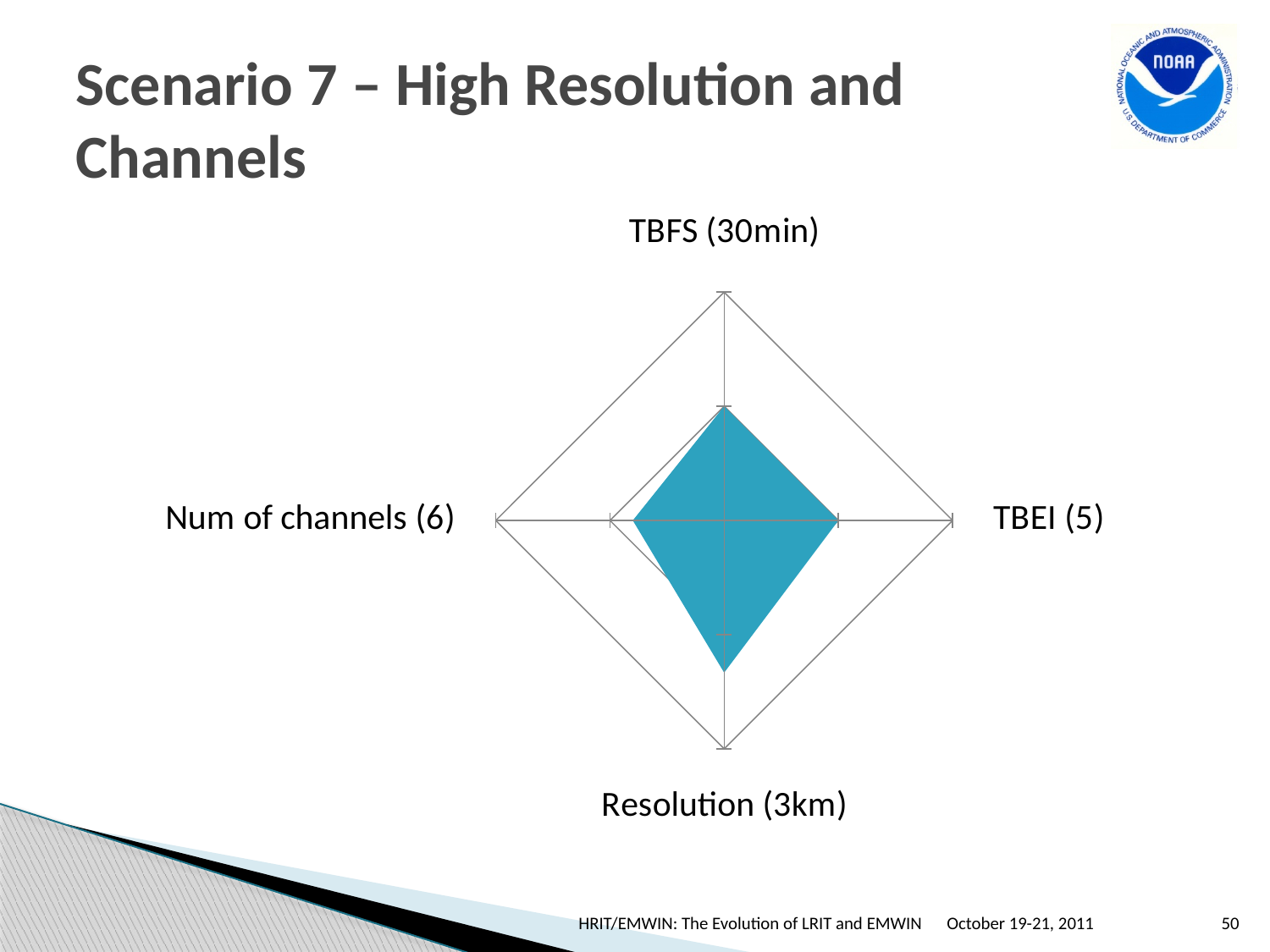
Which is larger on the radar chart, the value for Resolution (3km) or the value for Num of channels (6)? Resolution (3km) Which category label appears at the top of the radar chart? TBFS (30min) Which category has the lowest value on the radar chart? Num of channels (6) How many categories (axes) does the radar chart have? 4 Which category has the highest value on the radar chart? Resolution (3km) What colour is the filled area of the radar chart? Blue Which is larger on the radar chart, the value for TBFS (30min) or the value for Num of channels (6)? TBFS (30min) What kind of chart is shown on the slide? Radar chart Which is larger on the radar chart, the value for Resolution (3km) or the value for TBEI (5)? Resolution (3km)